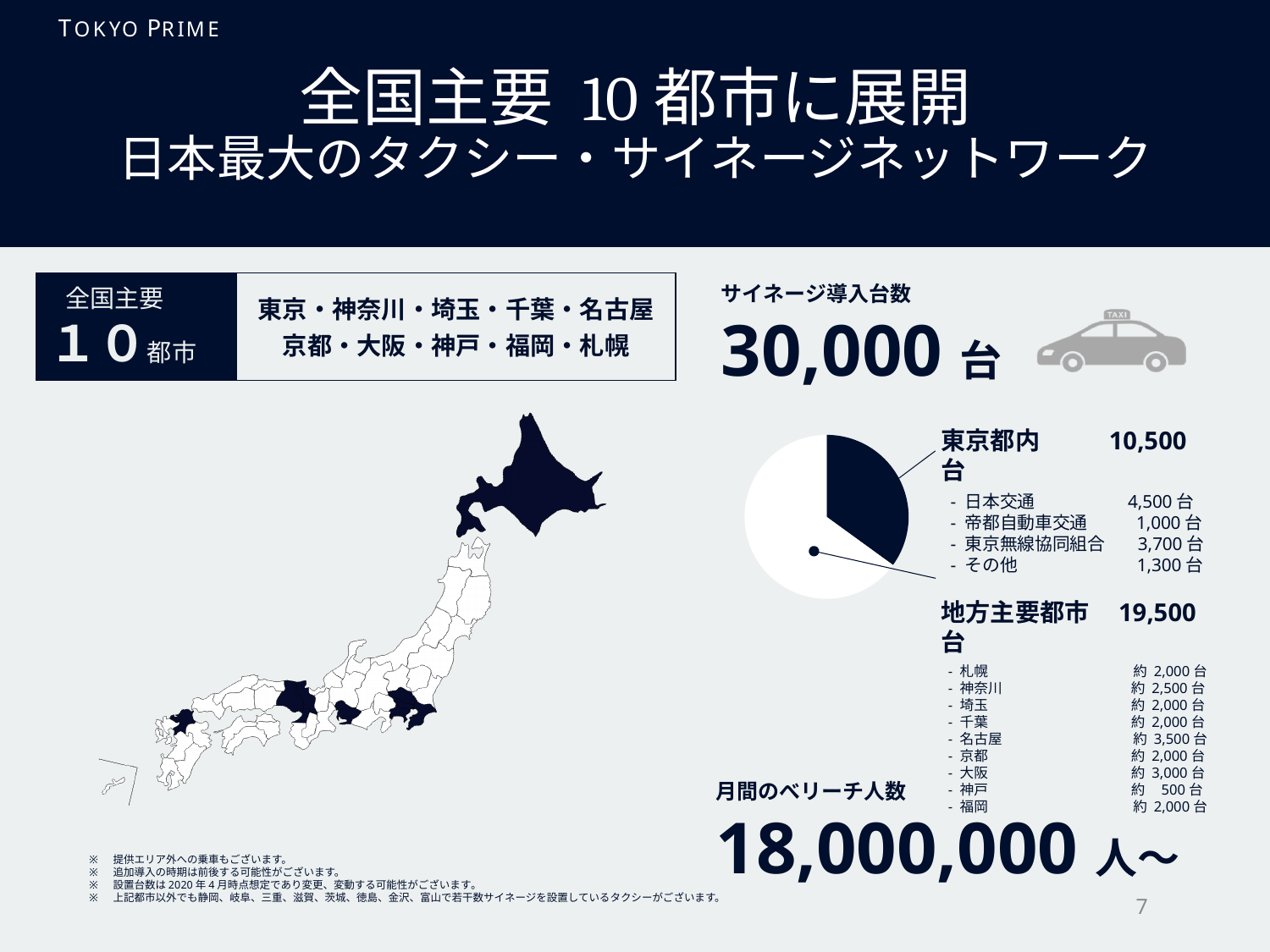
In the pie chart, how many units are attributed to 東京都内? 10,500 台 What colour is the 東京都内 slice of the pie chart? dark navy What kind of chart is shown on the slide next to the signage installation figures? pie chart What share of the pie chart does 地方主要都市 represent? 65% Which is larger in the pie chart, 東京都内 or 地方主要都市? 地方主要都市 Which slice of the pie chart is the largest? 地方主要都市 What is the difference between the 地方主要都市 value and the 東京都内 value in the pie chart? 9,000 台 Which slice of the pie chart is the smallest? 東京都内 What is the total of the two slices in the pie chart? 30,000 台 How many slices does the pie chart have? 2 In the pie chart, how many units are attributed to 地方主要都市? 19,500 台 What share of the pie chart does 東京都内 represent? 35%